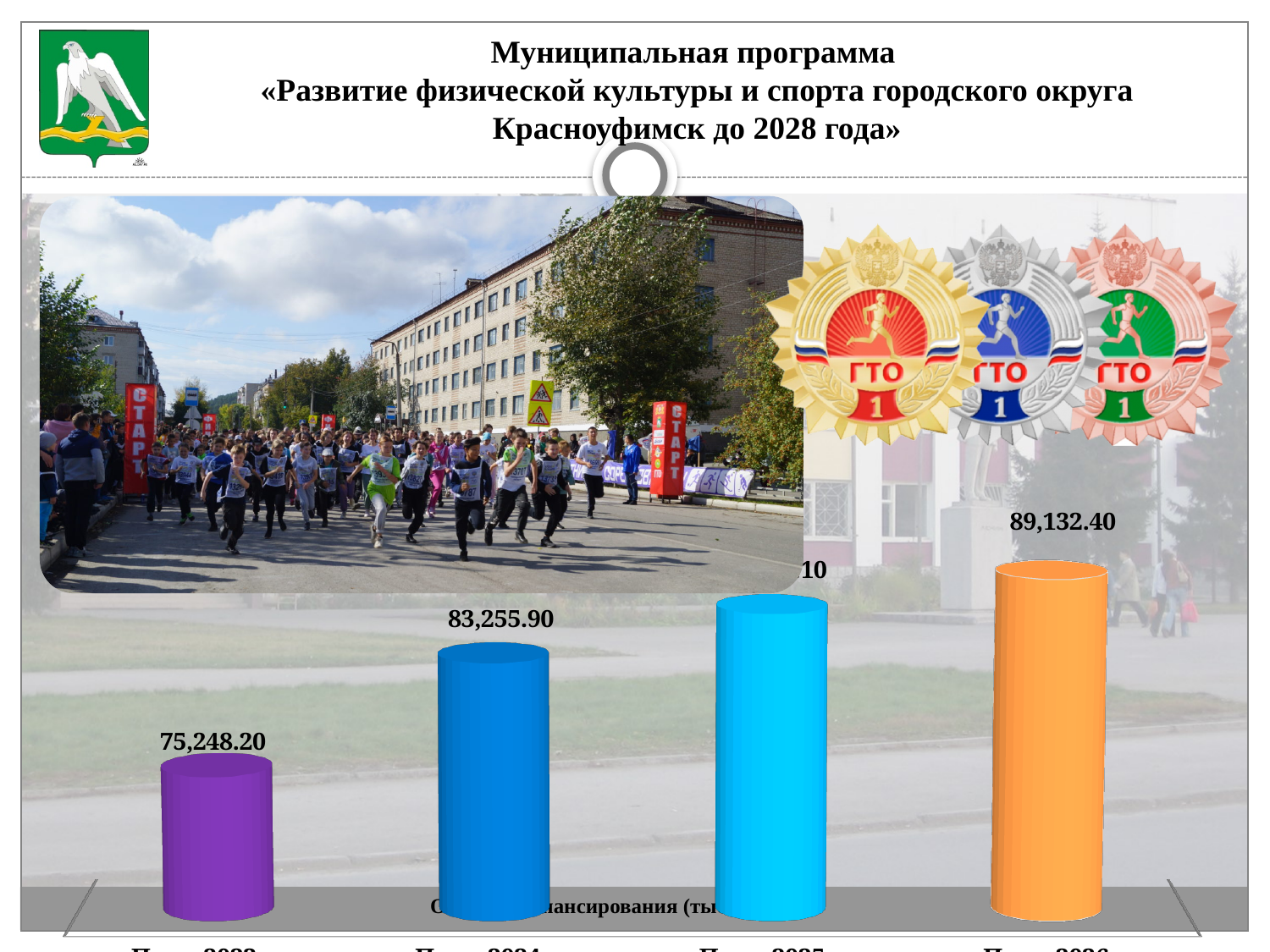
Do the bar values rise or fall from left to right across the chart? rise What is the value shown on the second (blue) bar of the chart? 83,255.90 Which bar in the chart has the highest value? the rightmost (orange) bar, 89,132.40 What kind of chart is shown on the slide? bar chart What is the difference between the values of the rightmost (orange) bar and the leftmost (purple) bar? 13,884.20 What is the value shown on the leftmost (purple) bar of the chart? 75,248.20 Which is larger: the value of the rightmost (orange) bar or the second (blue) bar? the rightmost (orange) bar What colour is the leftmost bar in the chart? purple Which bar in the chart has the lowest value? the leftmost (purple) bar, 75,248.20 What is the value shown on the rightmost (orange) bar of the chart? 89,132.40 How many bars does the chart on the slide have? 4 What is the difference between the values of the second (blue) bar and the leftmost (purple) bar? 8,007.70